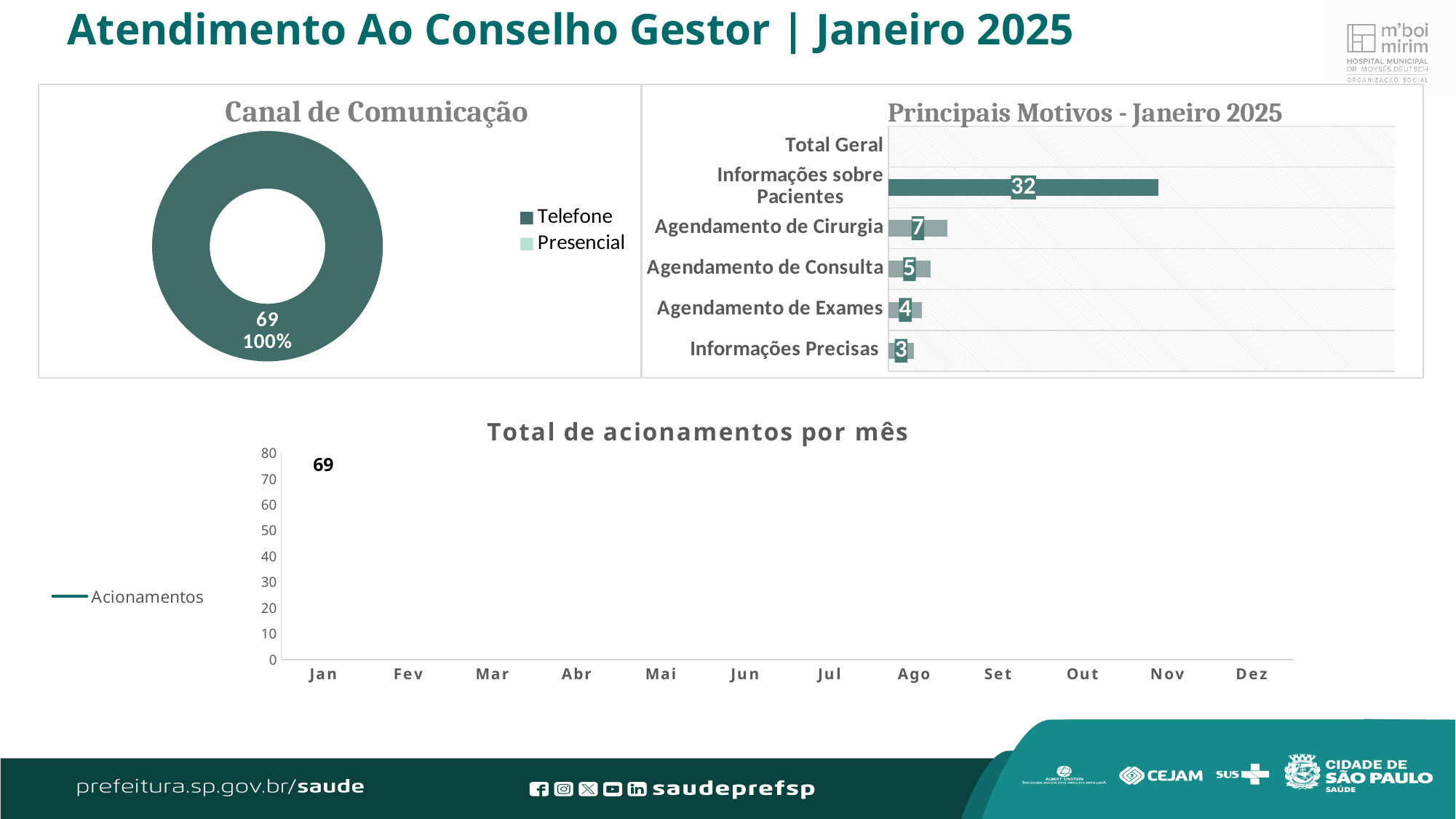
In the 'Principais Motivos - Janeiro 2025' chart, which category with a plotted bar has the lowest value? Informações Precisas How many months are shown on the x axis of the 'Total de acionamentos por mês' chart? 12 How many series does the legend of the 'Canal de Comunicação' chart list? 2 In the 'Principais Motivos - Janeiro 2025' chart, what is the value for Informações Precisas? 3 In the 'Principais Motivos - Janeiro 2025' chart, what is the difference between Informações sobre Pacientes and Agendamento de Cirurgia? 25 What kind of chart is 'Principais Motivos - Janeiro 2025'? Bar chart In the 'Principais Motivos - Janeiro 2025' chart, which category has the highest value? Informações sobre Pacientes In the 'Total de acionamentos por mês' chart, what is the value for Jan? 69 In the 'Principais Motivos - Janeiro 2025' chart, which is larger: Agendamento de Consulta or Agendamento de Exames? Agendamento de Consulta In the 'Principais Motivos - Janeiro 2025' chart, what is the value for Agendamento de Cirurgia? 7 In the 'Canal de Comunicação' chart, what share does Telefone have? 100% In the 'Principais Motivos - Janeiro 2025' chart, what is the value for Informações sobre Pacientes? 32